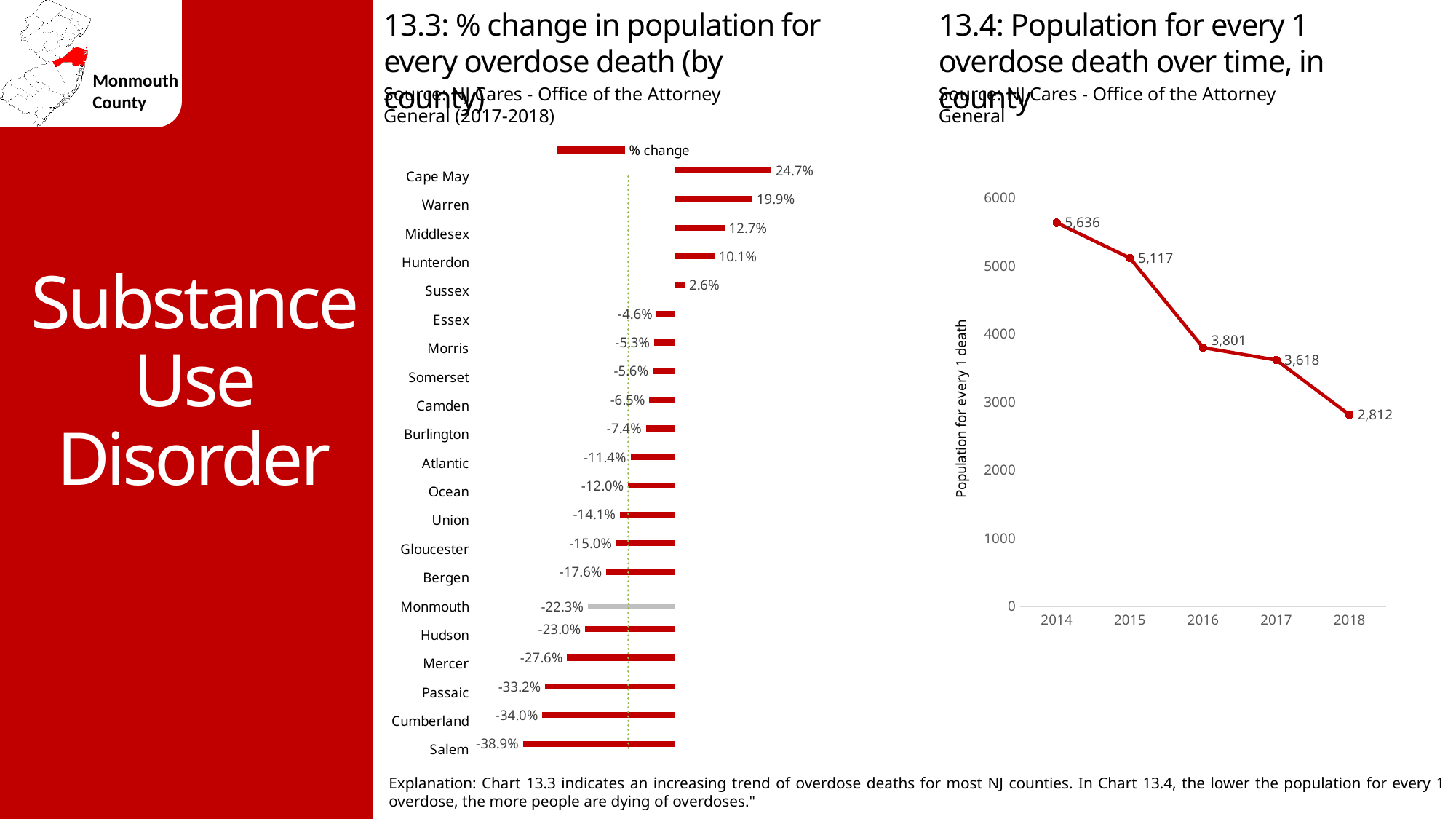
In chart 13.4, what is the population for every 1 overdose death in 2016? 3,801 In chart 13.3, what is the % change for Monmouth? -22.3% In chart 13.3, what is the difference between the % change for Cape May and Warren? 4.8 percentage points In chart 13.3, which county has the lowest % change? Salem In chart 13.3, what is the % change for Cape May? 24.7% What kind of chart is chart 13.3? Bar chart In chart 13.3, which county has the highest % change? Cape May In chart 13.4, what is the difference between the 2014 and 2018 values? 2,824 In chart 13.4, do the values rise or fall from 2014 to 2018? Fall In chart 13.3, which has a larger % change, Hudson or Mercer? Hudson In chart 13.4, how many years are plotted? 5 In chart 13.3, how many counties are plotted? 21